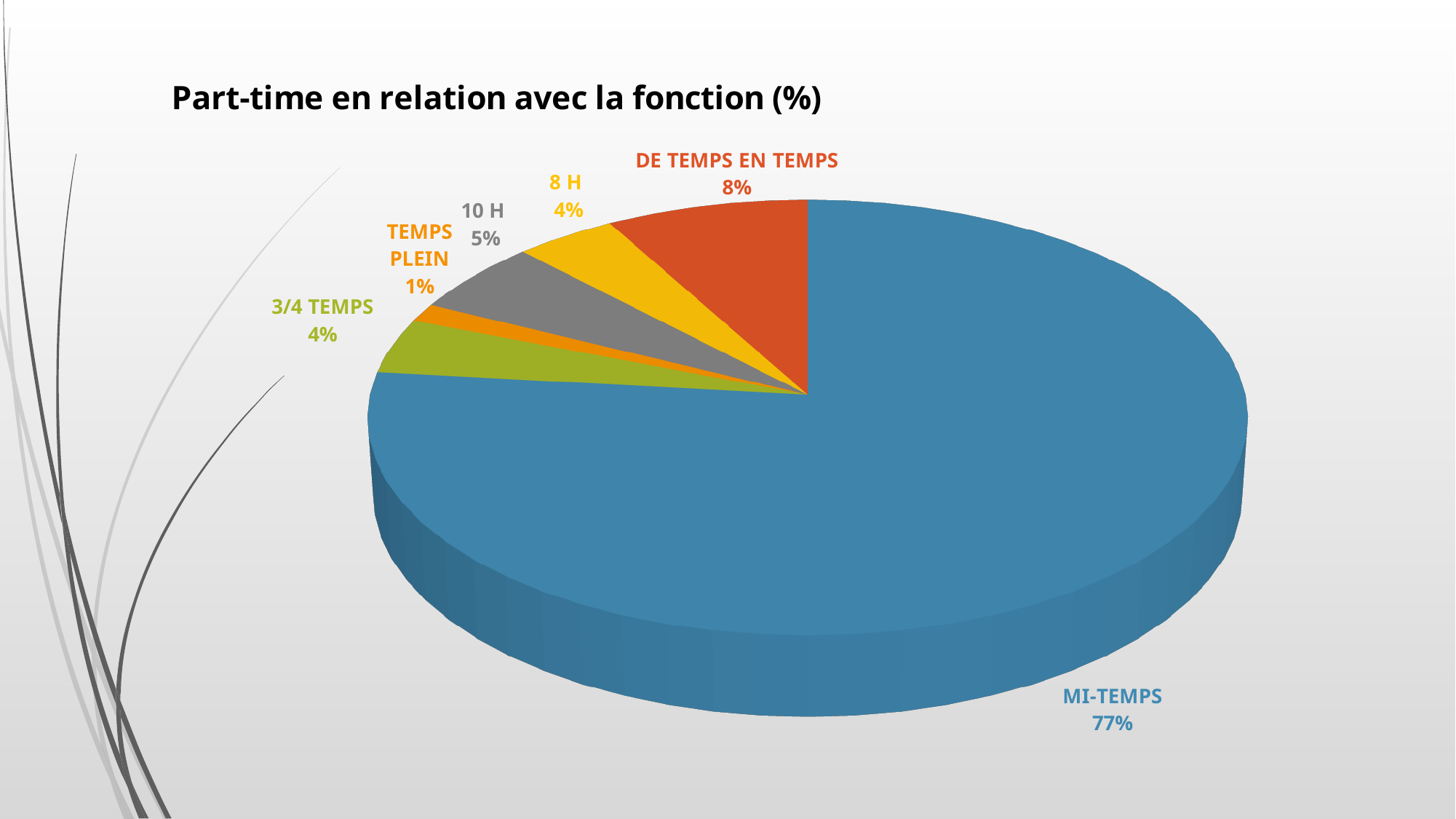
What colour is the MI-TEMPS slice? Blue Which category has the smallest share of the pie? TEMPS PLEIN Which is larger, the share for 10 H or the share for 8 H? 10 H What is the title of the chart? Part-time en relation avec la fonction (%) What type of chart is shown on the slide? Pie chart What percentage is shown for 10 H? 5% What is the difference between the MI-TEMPS share and the DE TEMPS EN TEMPS share? 69% Which category has the largest share of the pie? MI-TEMPS What percentage is shown for DE TEMPS EN TEMPS? 8% How many categories are shown in the pie chart? 6 What percentage is shown for TEMPS PLEIN? 1% What percentage is shown for MI-TEMPS? 77%